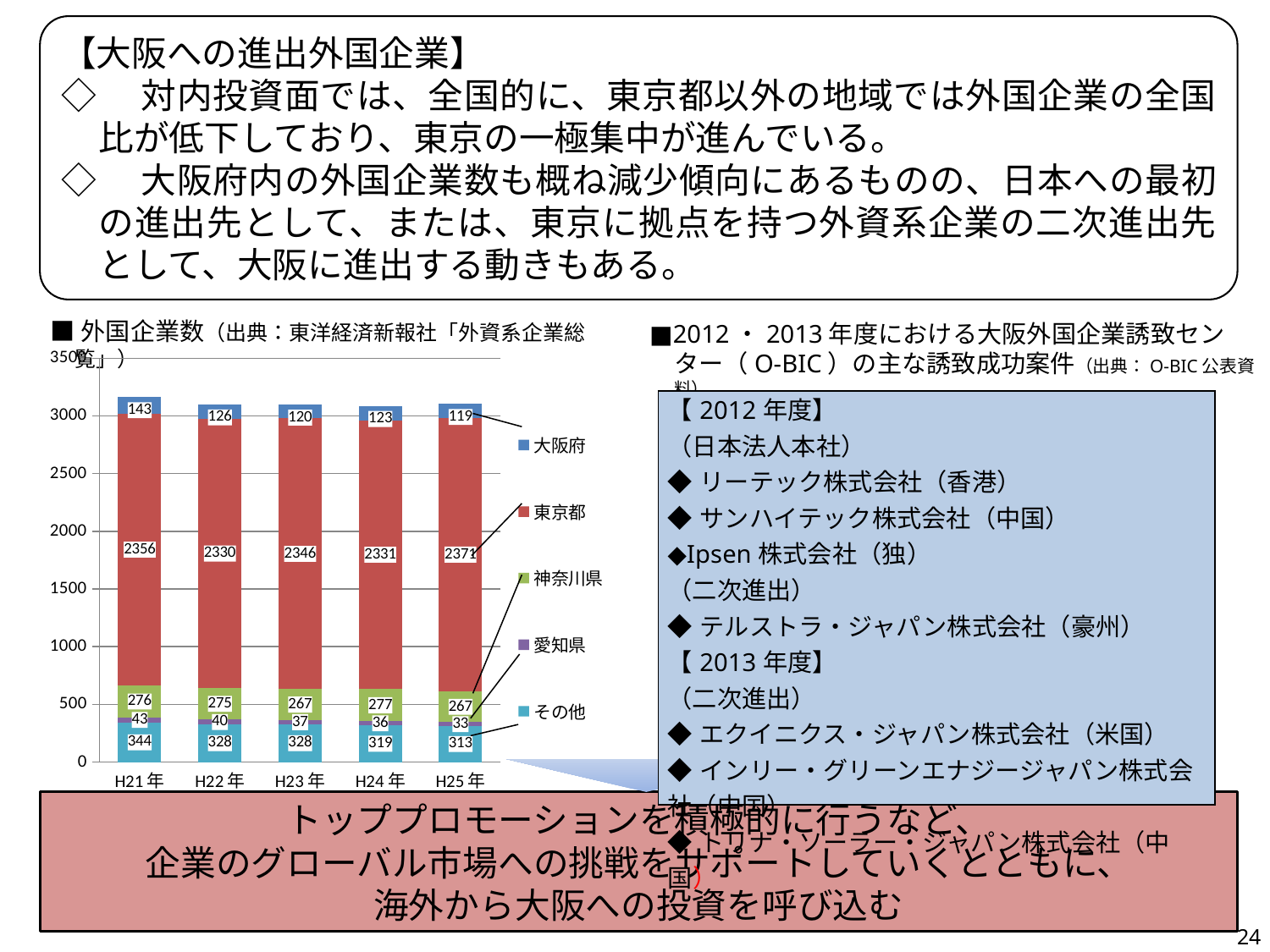
What is the difference between the 東京都 values for H25年 and H21年? 15 Do the values for 愛知県 rise or fall from H21年 to H25年? Fall What is the value for その他 in H23年? 328 In which year is the value for 大阪府 the highest? H21年 What kind of chart is shown? Stacked bar chart Which is larger, the 神奈川県 value for H24年 or for H23年? H24年 What is the value for 東京都 in H25年? 2371 In which year is the value for 愛知県 the lowest? H25年 How many series does the legend list? 5 What is the total of the stacked bar for H21年? 3162 How many years are shown on the x axis? 5 What is the value for 大阪府 in H21年? 143